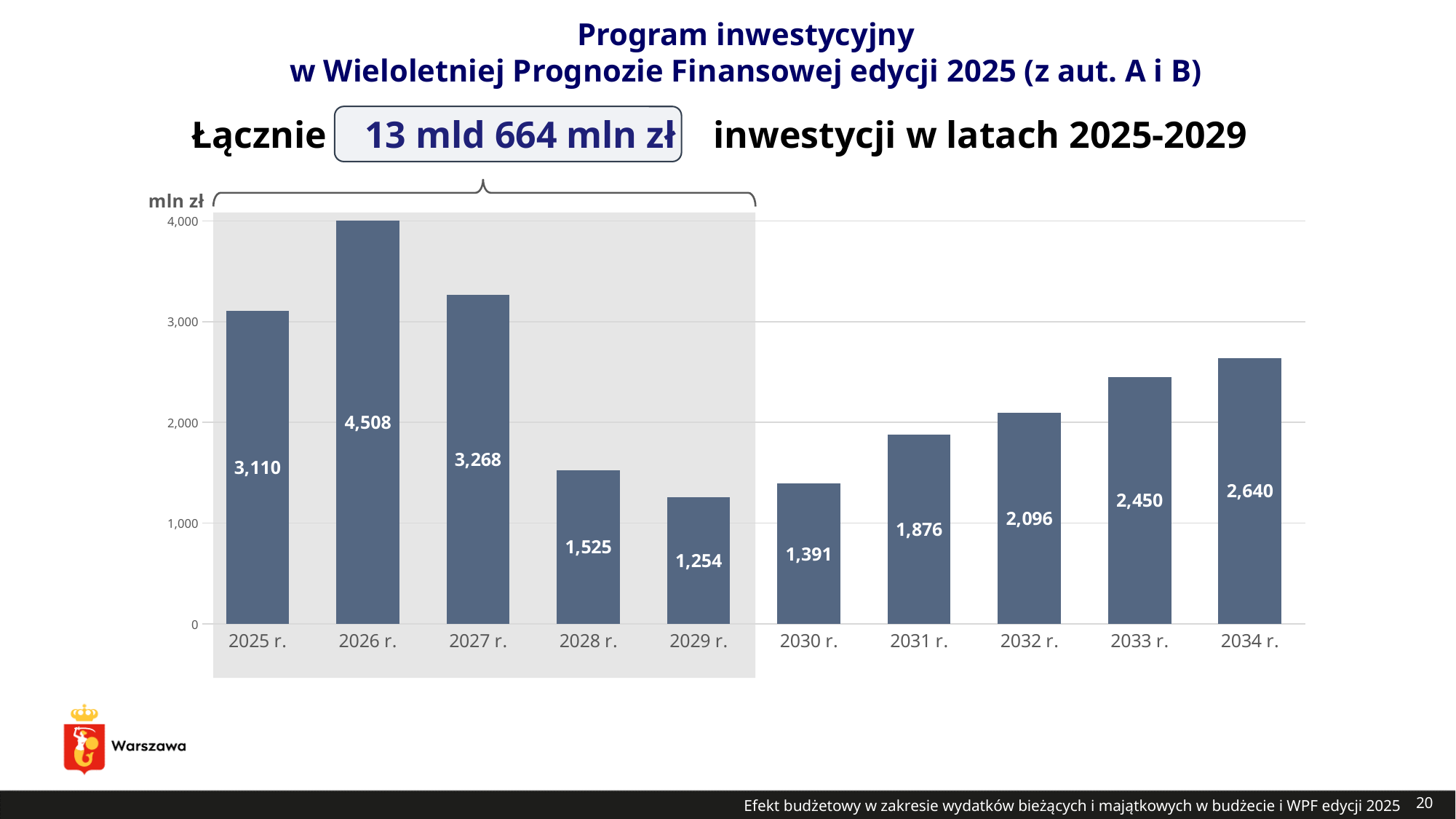
Do the values rise or fall from 2030 r. to 2034 r.? rise Is the value for 2034 r. greater or less than 3,000? less What is the difference between the values for 2026 r. and 2027 r.? 1,240 How many years are shown on the x axis? 10 What unit is shown at the top of the y axis? mln zł Which is larger, the value for 2028 r. or the value for 2030 r.? 2028 r. What kind of chart is shown on the slide? bar chart Which year has the highest value? 2026 r. What is the value for 2026 r.? 4,508 Which year has the lowest value? 2029 r. What is the value for 2029 r.? 1,254 What is the value for 2033 r.? 2,450